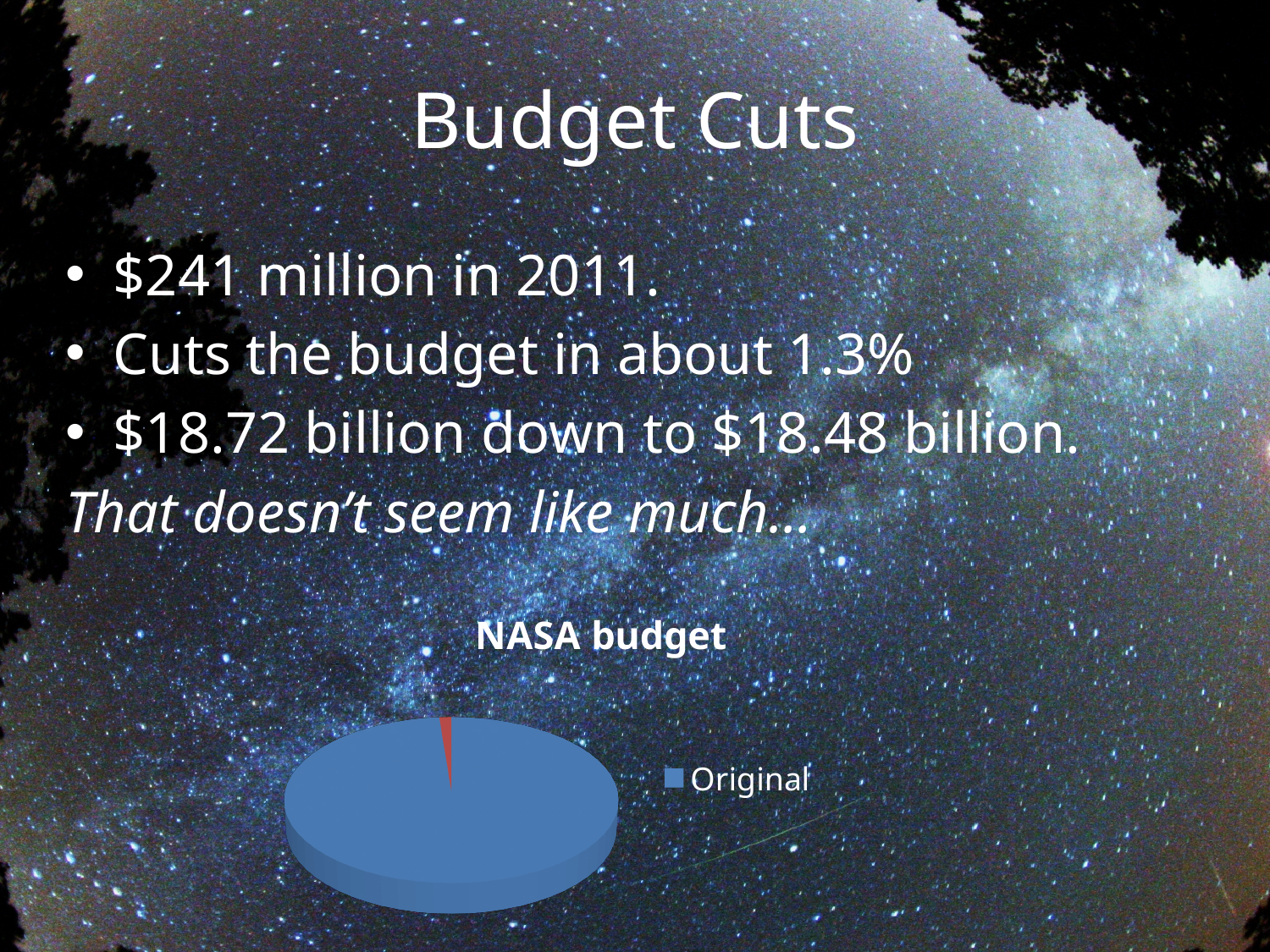
What is the only entry shown in the chart's legend? Original What kind of chart is shown on the slide? pie chart Which slice is larger, the blue slice or the red slice? the blue slice Which category takes up the largest share of the pie? Original What is the title of the chart? NASA budget How many slices are visible in the pie chart? 2 How many entries does the chart's legend list? 1